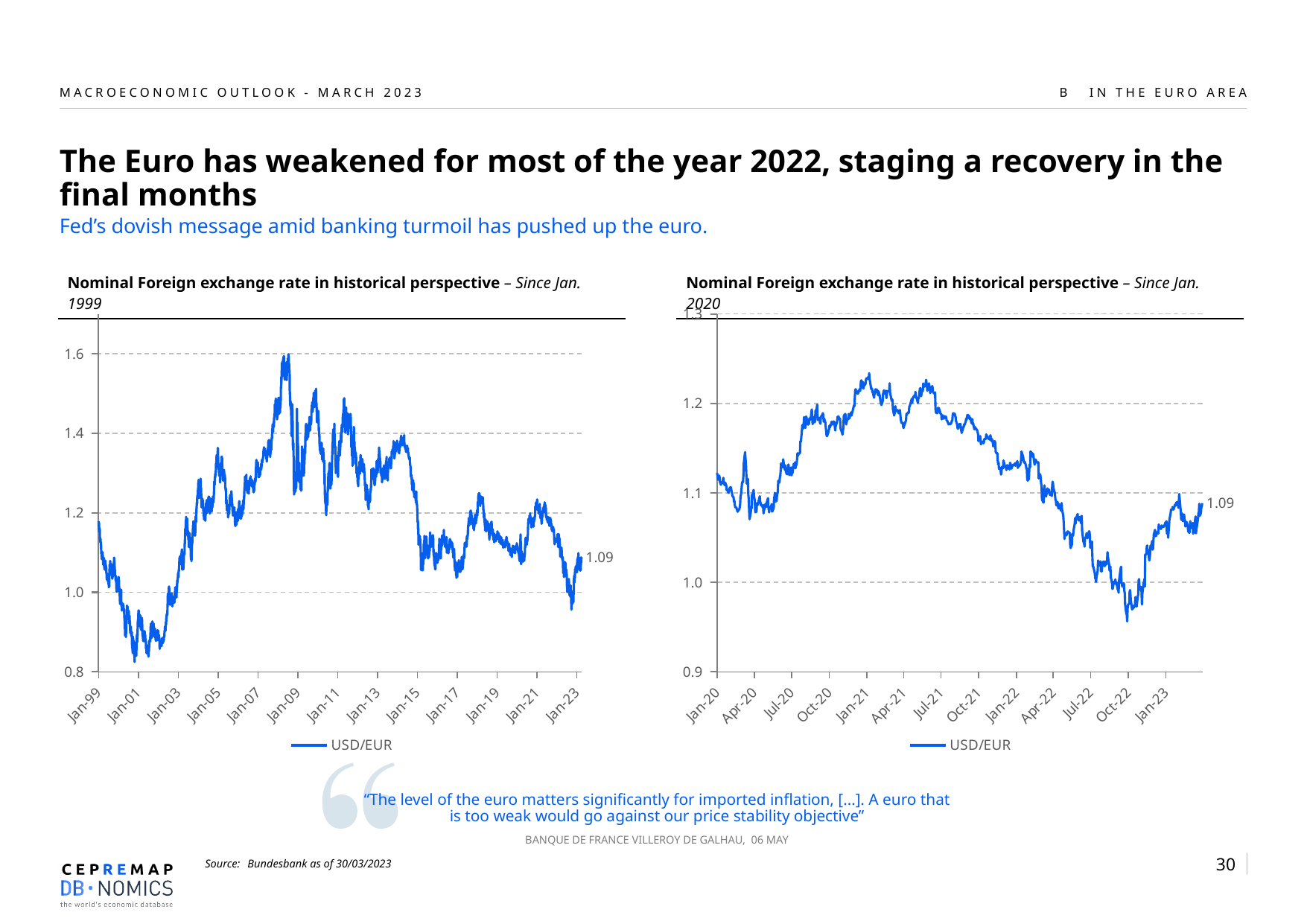
In the right chart (since Jan. 2020), does the USD/EUR rate rise or fall between Oct-22 and Jan-23? rise In the left chart (since Jan. 1999), what is the latest USD/EUR value labelled at the end of the line? 1.09 In the right chart (since Jan. 2020), does the USD/EUR rate rise or fall between Jul-21 and Oct-22? fall In the left chart (since Jan. 1999), is the USD/EUR value around Jan-01 greater or less than 1.0? less In the left chart (since Jan. 1999), is the peak USD/EUR value around 2008 greater or less than 1.4? greater What colour is the USD/EUR line in the left chart (since Jan. 1999)? Blue What series name appears in the legend of the left chart (since Jan. 1999)? USD/EUR How many series does the legend of the right chart (since Jan. 2020) list? 1 In the right chart (since Jan. 2020), is the USD/EUR value around Jan-21 greater or less than 1.2? greater In the right chart (since Jan. 2020), what is the latest USD/EUR value labelled at the end of the line? 1.09 What kind of chart is the left chart, 'Nominal Foreign exchange rate in historical perspective – Since Jan. 1999'? Line chart